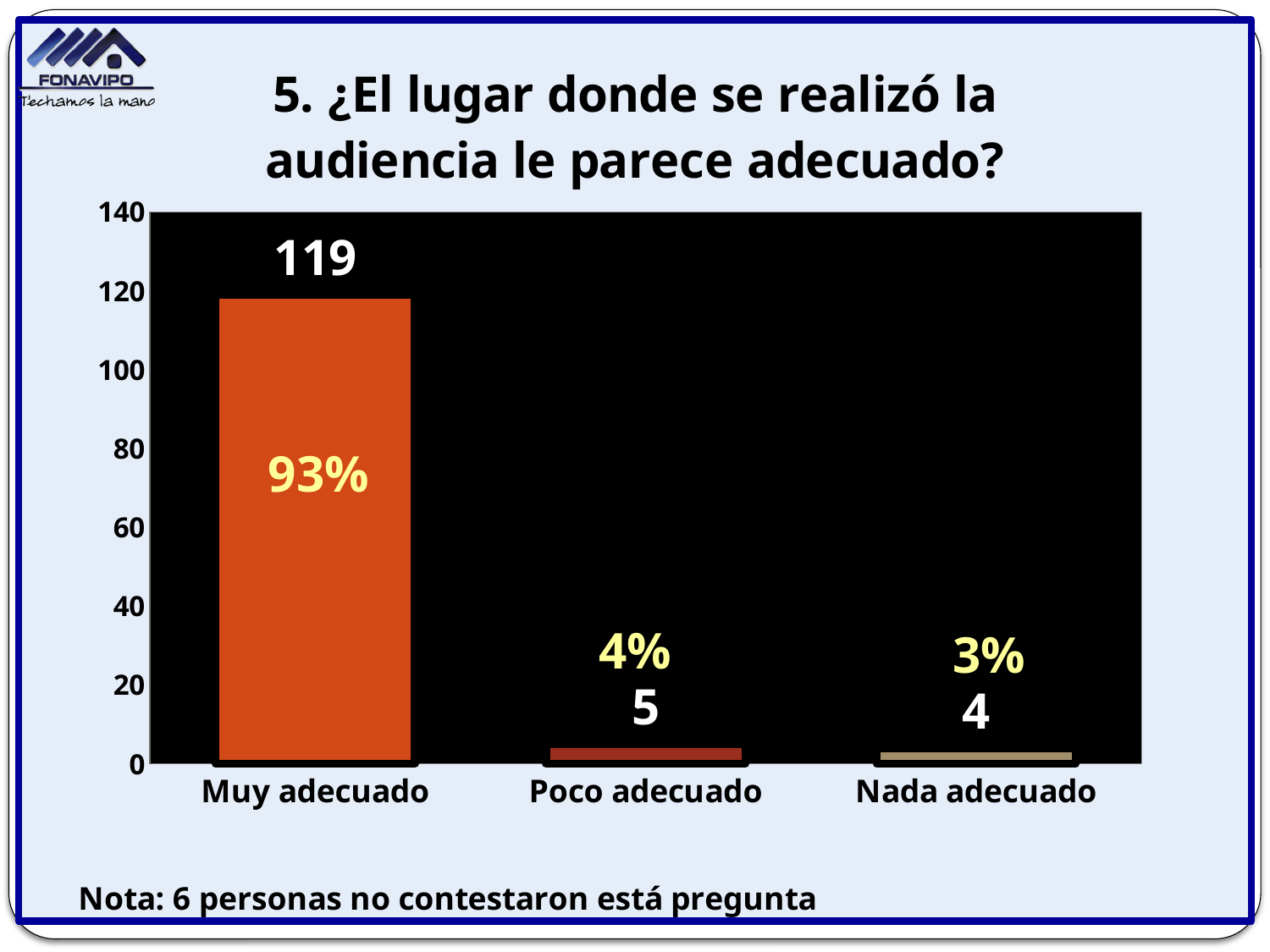
What is the difference between the values for Muy adecuado and Poco adecuado? 114 What is the value for Nada adecuado? 4 What is the value for Muy adecuado? 119 What percentage is shown for Muy adecuado? 93% How many categories are shown on the x axis? 3 Is the value for Muy adecuado greater or less than 100? greater Which is larger, the value for Poco adecuado or the value for Nada adecuado? Poco adecuado What is the value for Poco adecuado? 5 Which category has the highest value? Muy adecuado Which category has the lowest value? Nada adecuado What percentage is shown for Poco adecuado? 4% What kind of chart is shown on the slide? bar chart